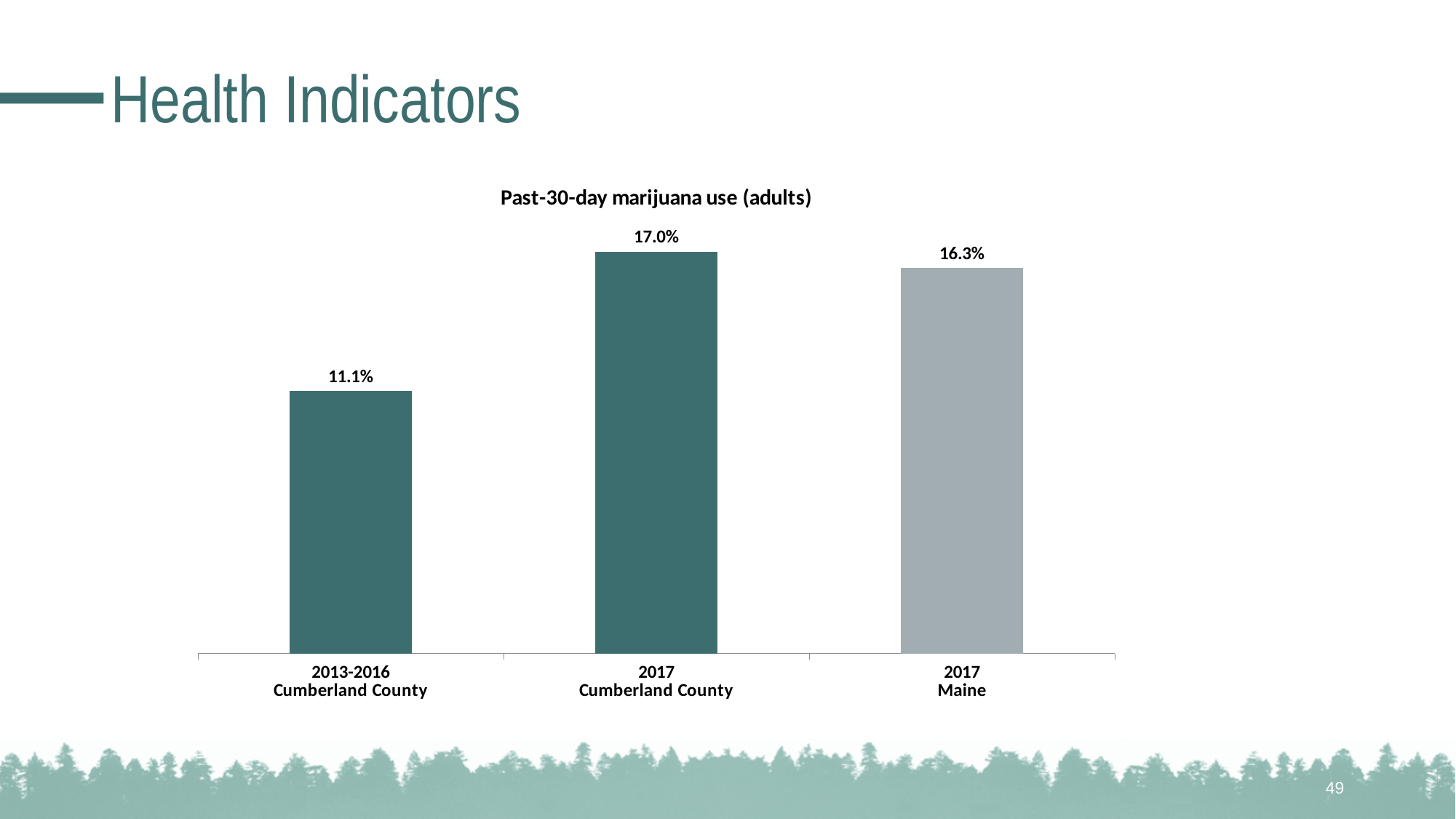
What is the title of the chart? Past-30-day marijuana use (adults) Which bar is coloured grey rather than teal? 2017 Maine What is the value for 2017 Cumberland County? 17.0% How many bars are shown in the chart? 3 What is the value for 2017 Maine? 16.3% What kind of chart is shown on the slide? Bar chart Which is larger, the value for 2017 Maine or the value for 2013-2016 Cumberland County? 2017 Maine Which category has the highest value? 2017 Cumberland County What is the difference between the 2017 Cumberland County value and the 2013-2016 Cumberland County value? 5.9% Which category has the lowest value? 2013-2016 Cumberland County What is the difference between the 2017 Cumberland County value and the 2017 Maine value? 0.7% What is the value for 2013-2016 Cumberland County? 11.1%